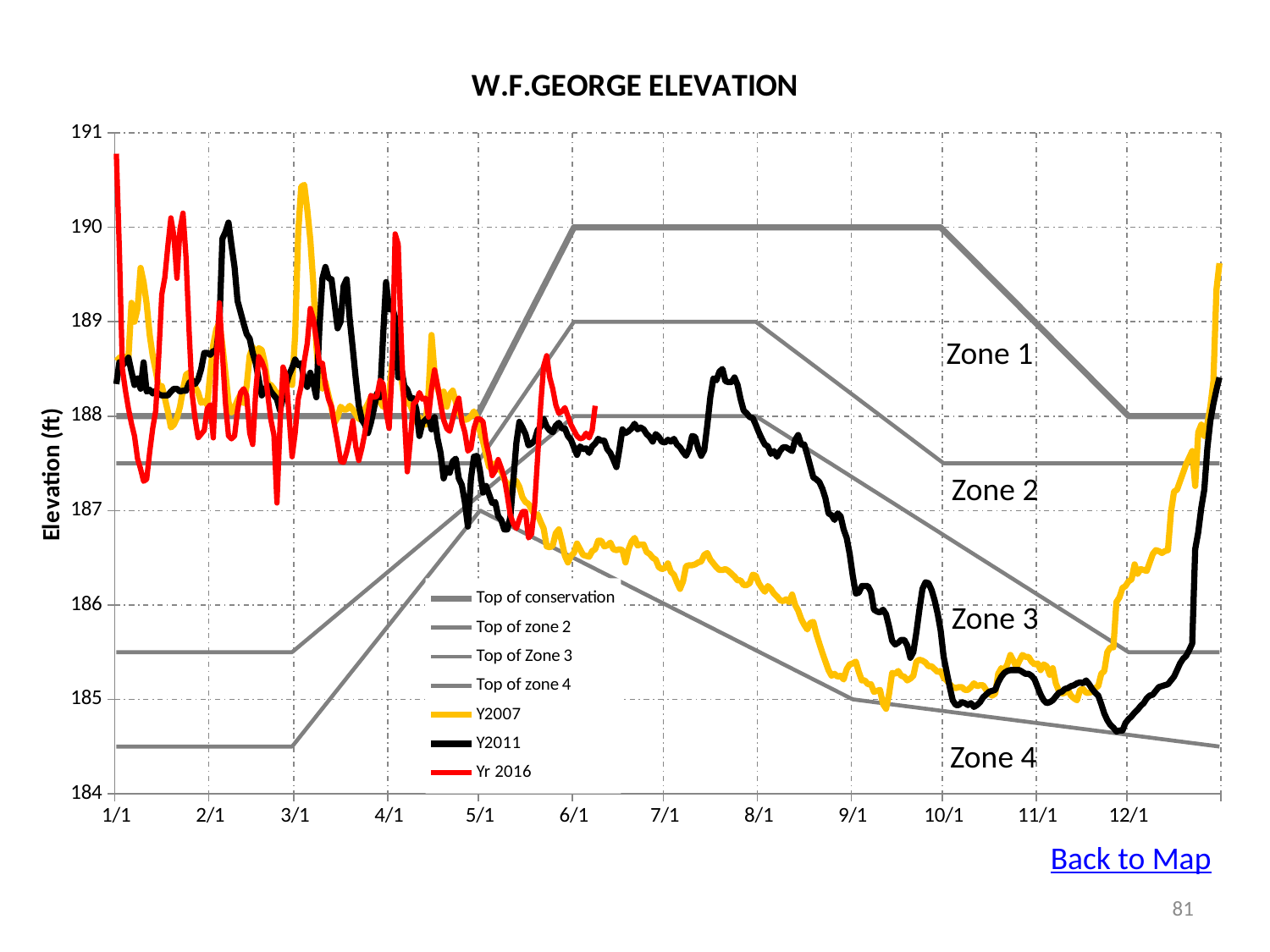
What is the title of the chart? W.F.GEORGE ELEVATION What is the difference between the Top of conservation value at 8/1 and its value at 1/1? 2 How many series does the legend list? 7 What is the label on the vertical axis? Elevation (ft) What is the value of the Top of conservation line between 6/1 and 10/1? 190 What is the value of the Top of conservation line at 1/1? 188 At 9/1, which series has the higher value, Y2011 or Y2007? Y2011 Is the Y2007 value at 8/1 greater or less than 186? greater What is the value of the Top of zone 4 line at 5/1? 187 What is the value of the Top of zone 4 line at 9/1? 185 What kind of chart is shown on the slide? line chart Is the Y2011 value at 7/1 greater or less than 188? less